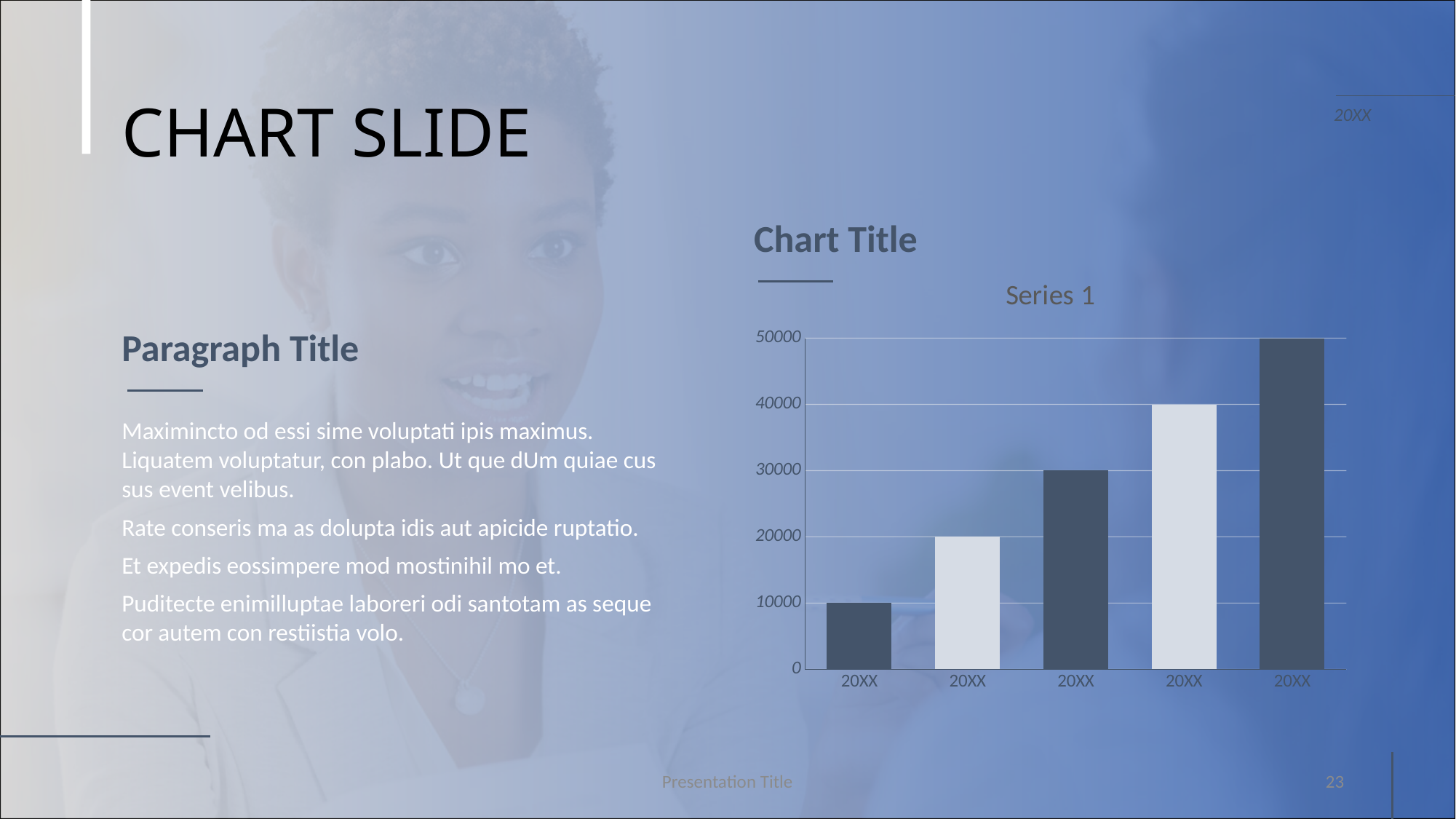
Which bar is the tallest in the chart? the fifth (rightmost) bar What is the value of the third bar in the chart? 30000 What is the title shown above the chart's plot area? Series 1 Do the bar values rise or fall from left to right along the x axis? rise Which is larger, the second bar or the fourth bar? the fourth bar Which bar is the shortest in the chart? the first (leftmost) bar What is the difference between the fourth bar and the second bar? 20000 What is the highest value shown on the chart's vertical axis? 50000 How many bars does the chart have? 5 What kind of chart is shown on the slide? bar chart What is the value of the first (leftmost) bar in the chart? 10000 What is the value of the fifth (rightmost) bar in the chart? 50000